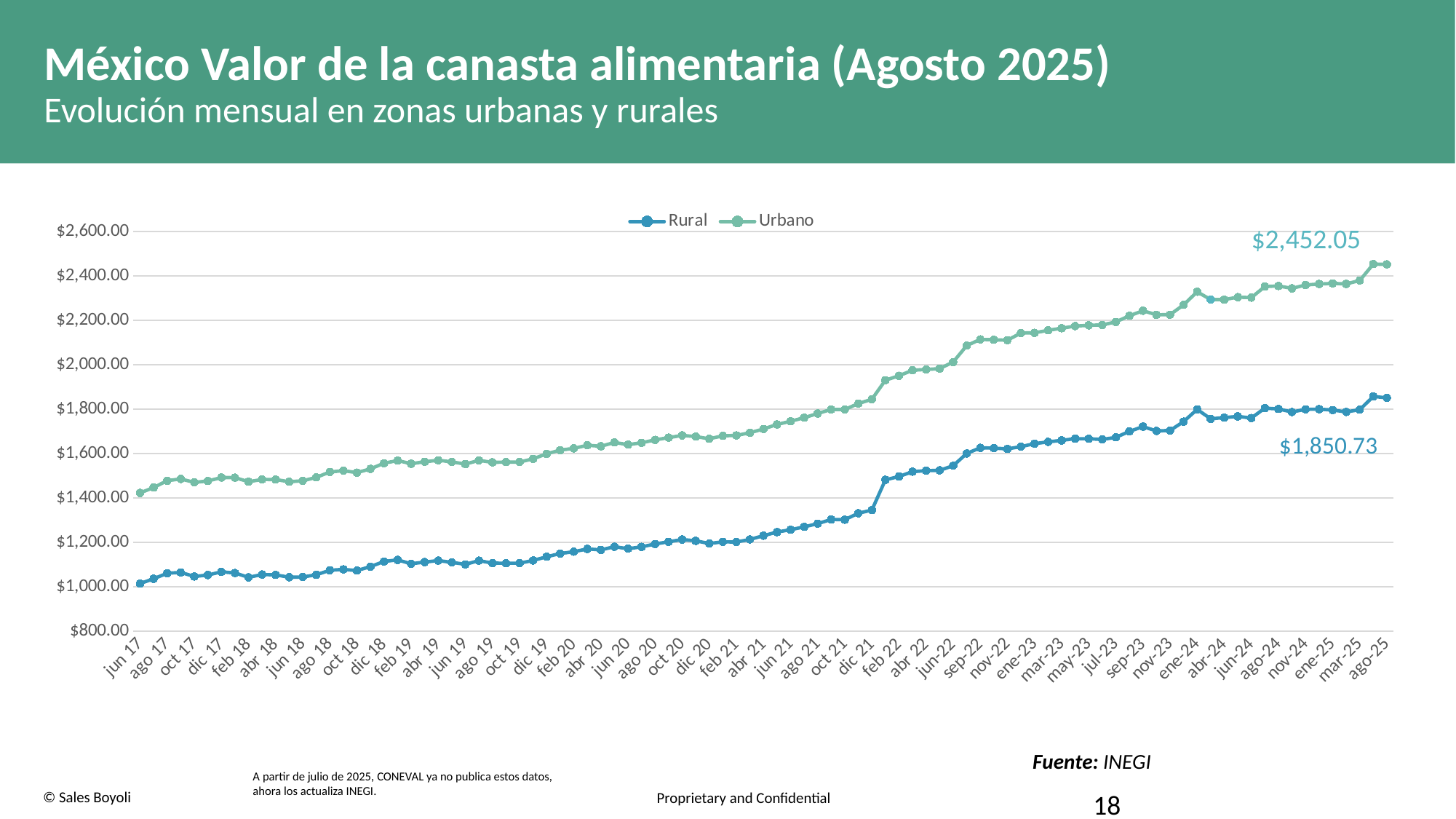
Do the Urbano values generally rise or fall from jun 17 to ago-25? rise Is the Urbano value at ene-24 greater or less than $2,200.00? greater What is the value of the Rural series at ago-25? $1,850.73 Is the Urbano value at jun 17 greater or less than $1,600.00? less What is the difference between the Urbano and Rural values at ago-25? $601.32 Which series is plotted in green? Urbano What kind of chart is shown on the slide? line chart At ago-25, which series has the larger value, Rural or Urbano? Urbano Is the Rural value at jun 17 greater or less than $1,200.00? less What is the value of the Urbano series at ago-25? $2,452.05 How many series does the legend list? 2